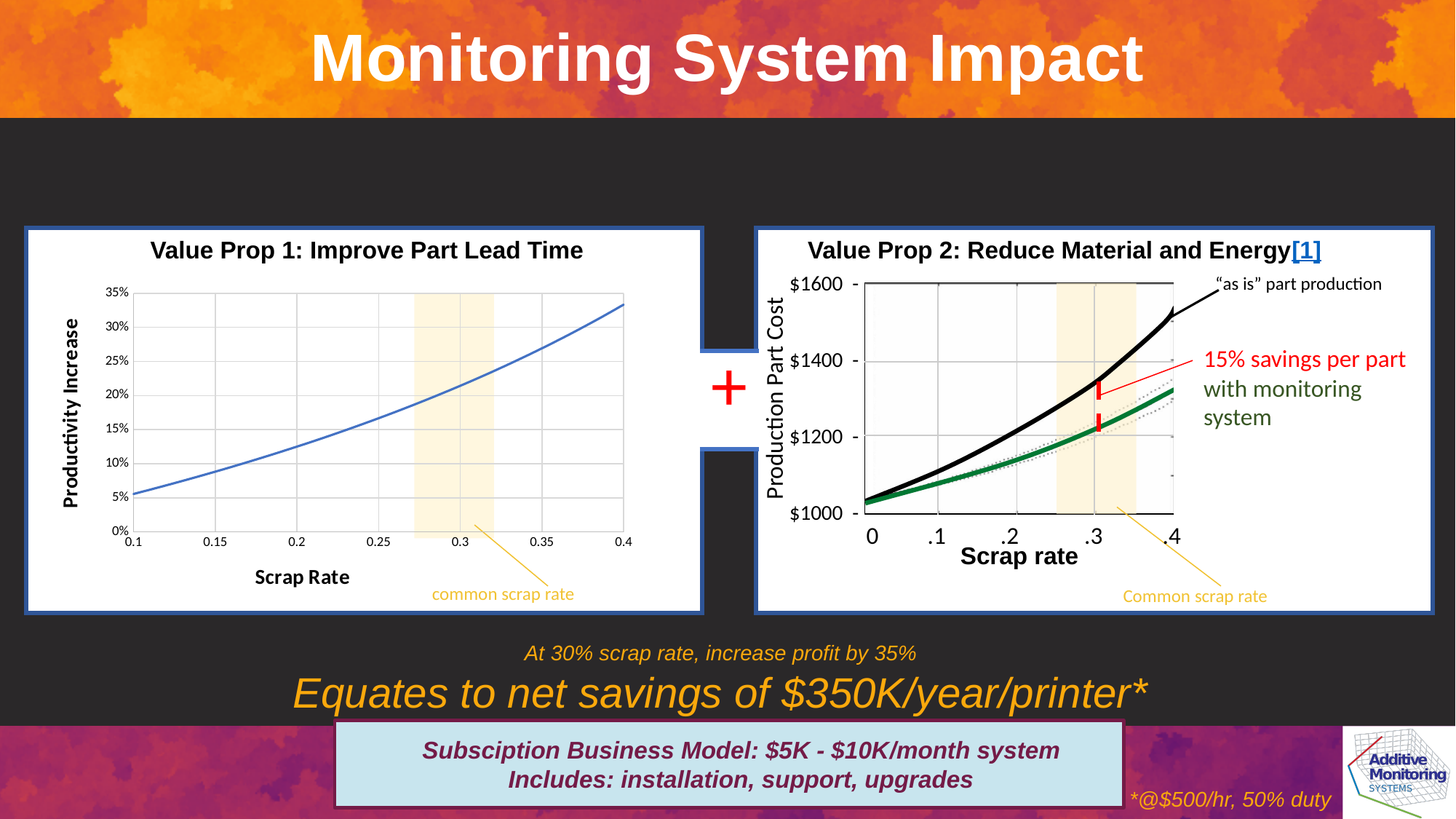
How many lines (series) are labelled in the 'Value Prop 2: Reduce Material and Energy' chart? 2 In the 'Value Prop 1: Improve Part Lead Time' chart, is the Productivity Increase at a Scrap Rate of 0.4 greater or less than 30%? greater What is the y-axis title of the 'Value Prop 2: Reduce Material and Energy' chart? Production Part Cost In the 'Value Prop 2: Reduce Material and Energy' chart, is the cost with monitoring system at a scrap rate of .4 greater or less than $1400? less What type of chart is shown under 'Value Prop 1: Improve Part Lead Time'? line chart In the 'Value Prop 1: Improve Part Lead Time' chart, does Productivity Increase rise or fall as Scrap Rate increases? rise What type of chart is shown under 'Value Prop 2: Reduce Material and Energy'? line chart In the 'Value Prop 1: Improve Part Lead Time' chart, is the Productivity Increase at a Scrap Rate of 0.2 greater or less than 10%? greater In the 'Value Prop 2: Reduce Material and Energy' chart, at a scrap rate of .3, which line shows the higher Production Part Cost: 'as is' part production or with monitoring system? "as is" part production What is the x-axis title of the 'Value Prop 1: Improve Part Lead Time' chart? Scrap Rate